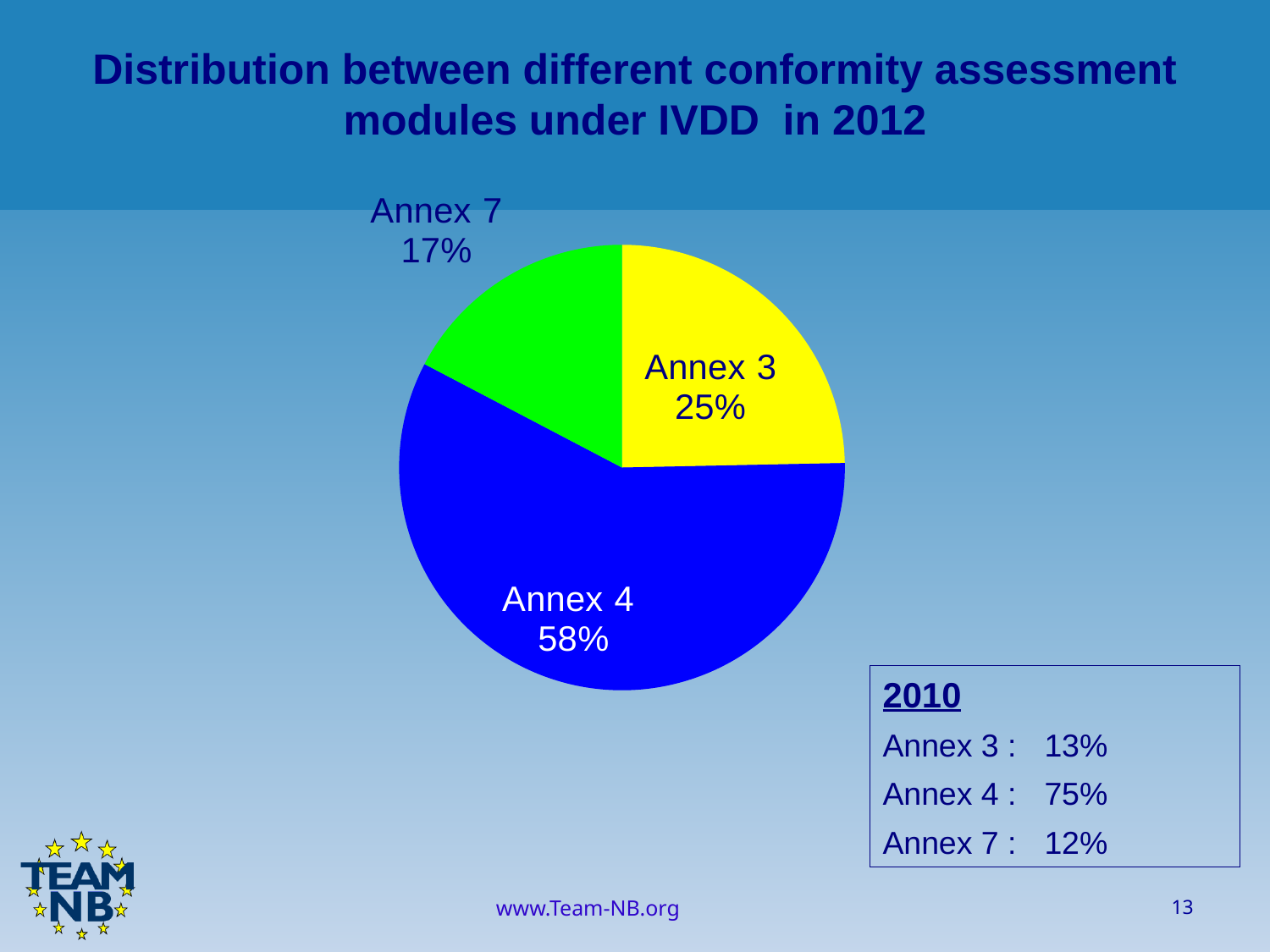
What kind of chart is shown on the slide? pie chart What colour is the Annex 4 slice of the pie? blue What share of the pie does Annex 3 represent? 25% What is the title of the chart? Distribution between different conformity assessment modules under IVDD in 2012 What share of the pie does Annex 7 represent? 17% What is the difference in percentage points between Annex 3 and Annex 7? 8% What share of the pie does Annex 4 represent? 58% Which annex has the largest slice of the pie? Annex 4 What is the difference in percentage points between Annex 4 and Annex 3? 33% Which is larger, the slice for Annex 3 or the slice for Annex 7? Annex 3 How many slices does the pie chart have? 3 Which annex has the smallest slice of the pie? Annex 7